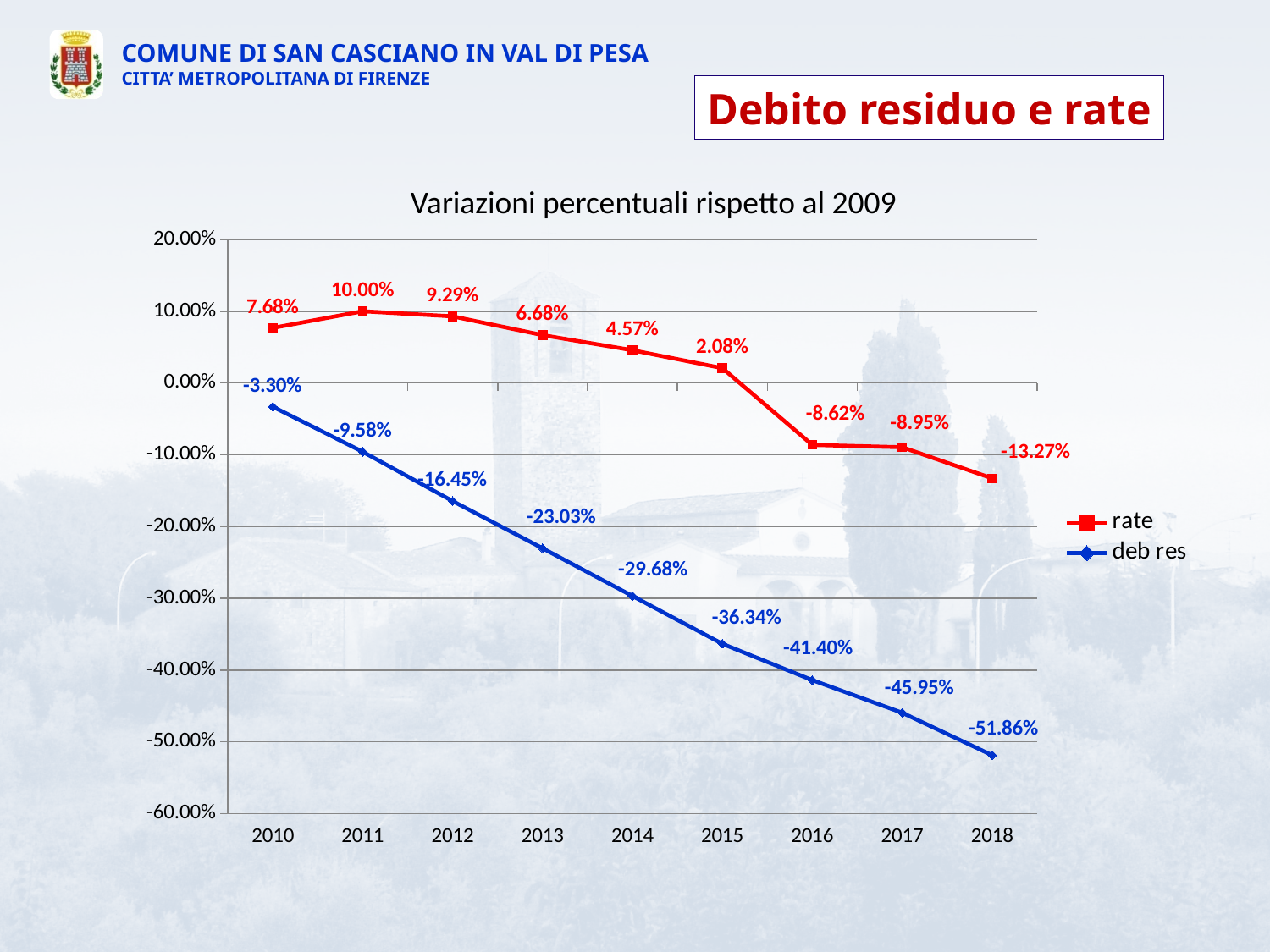
How many years are shown on the x axis? 9 Does the deb res series rise or fall from 2010 to 2018? fall Which series has the larger value in 2014, rate or deb res? rate In which year is the rate series at its highest? 2011 How many series does the legend list? 2 What is the difference between the rate value in 2011 and the rate value in 2018? 23.27% What is the value of the rate series in 2016? -8.62% What is the value of the deb res series in 2013? -23.03% In which year is the deb res series at its lowest? 2018 What is the value of the rate series in 2011? 10.00% What kind of chart is shown on the slide? line chart What is the value of the deb res series in 2018? -51.86%